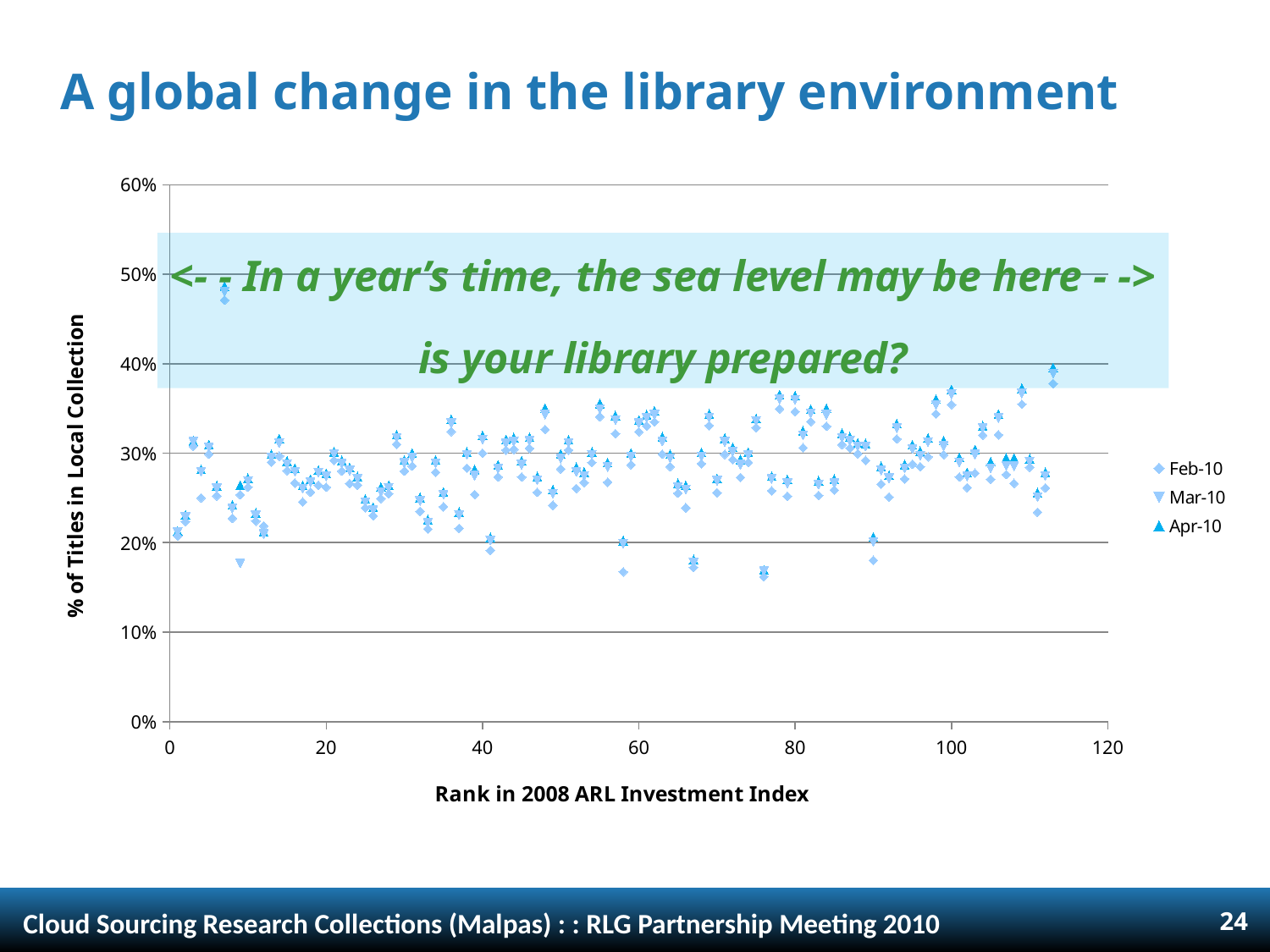
What are the series names listed in the legend? Feb-10, Mar-10, Apr-10 Is the lowest plotted value on the chart greater or less than 10%? greater How many series does the legend list? 3 Is the highest plotted value on the chart greater or less than 50%? less Is the highest plotted value on the chart greater or less than 40%? greater What is the maximum value shown on the vertical axis? 60% What is the label of the horizontal axis? Rank in 2008 ARL Investment Index What kind of chart is shown on the slide? Scatter chart